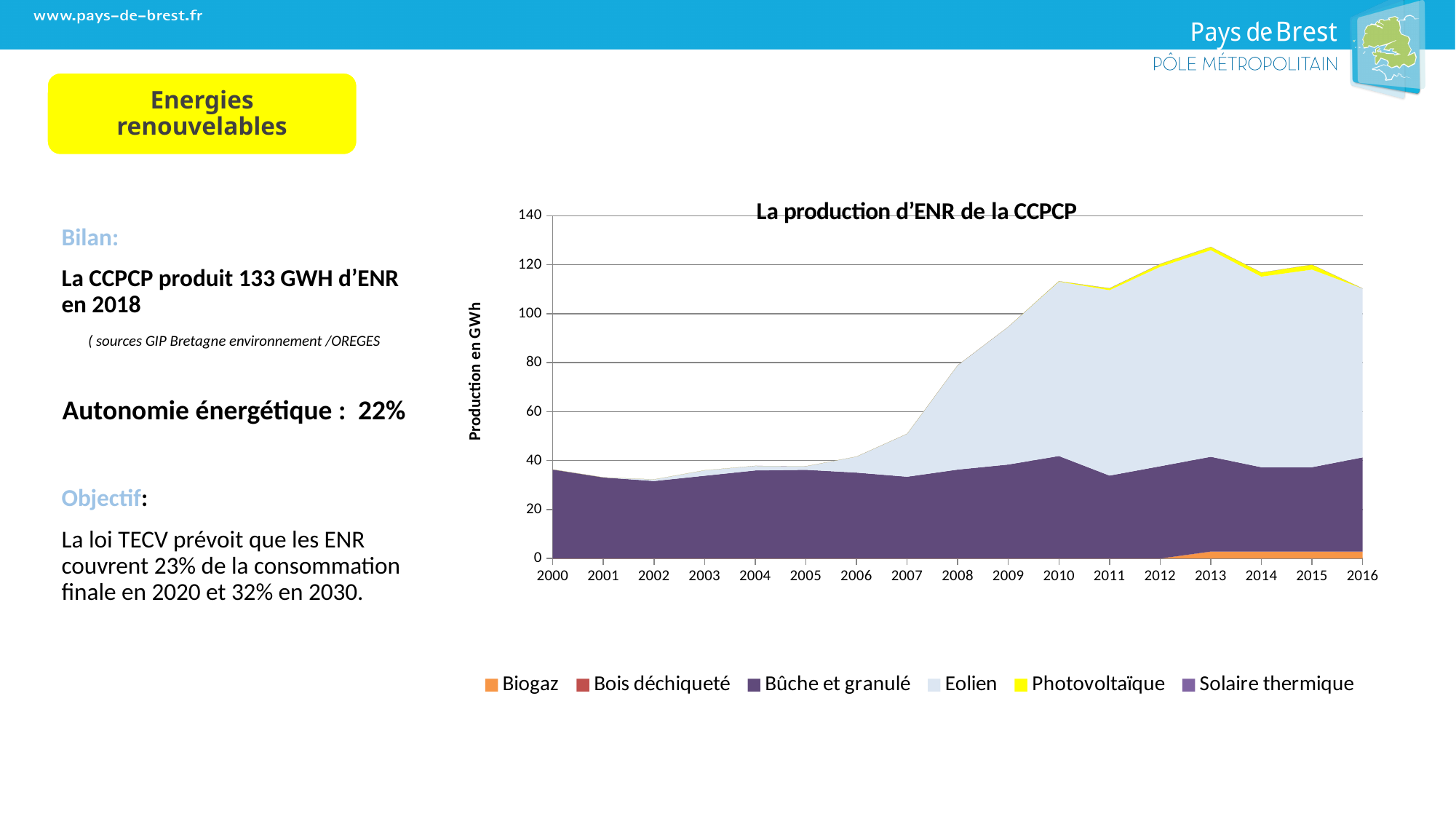
What is the title of the chart? La production d'ENR de la CCPCP Which year has the larger total production, 2005 or 2010? 2010 Does the total production generally rise or fall between 2000 and 2013? rise Is the total production in 2010 greater or less than 100? greater Is the total production in 2000 greater or less than 40? less In which year does the total production reach its highest level? 2013 Is the total production in 2007 greater or less than 60? less What is the label of the vertical axis of the chart? Production en GWh How many years are shown along the x axis of the chart? 17 What kind of chart is shown on the slide? Stacked area chart How many series does the chart legend list? 6